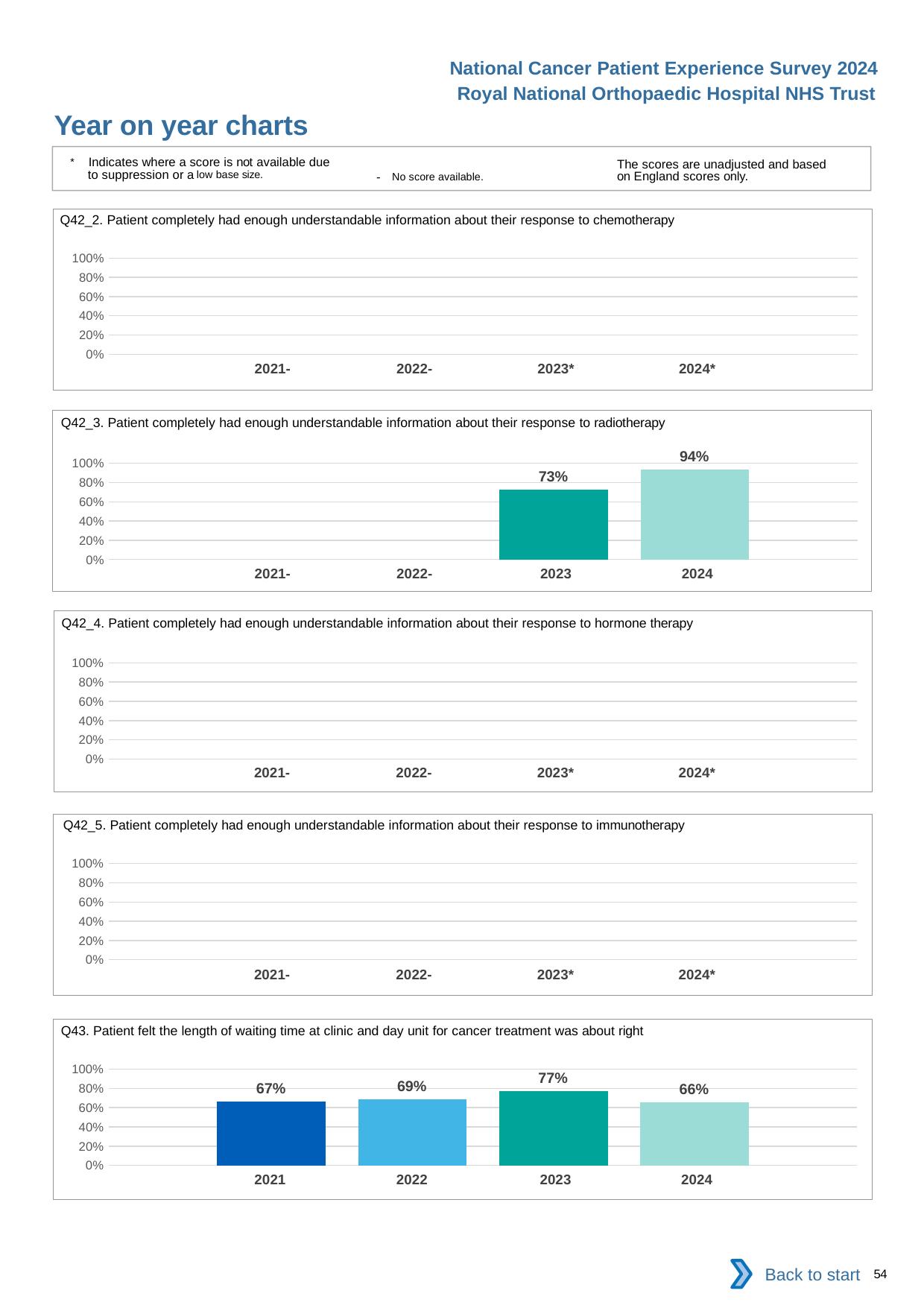
What kind of chart is the Q43 chart (waiting time at clinic and day unit)? bar chart In the Q42_3 chart (radiotherapy), what is the difference between the 2024 and 2023 values? 21% In the Q43 chart (waiting time at clinic and day unit), what is the difference between the 2023 and 2024 values? 11% In the Q42_3 chart (radiotherapy), how many years have a bar plotted? 2 In the Q43 chart (waiting time at clinic and day unit), which year has the highest value? 2023 In the Q42_3 chart (radiotherapy), is the value for 2023 greater or less than 80%? less In the Q43 chart (waiting time at clinic and day unit), which year has the lowest value? 2024 In the Q43 chart (waiting time at clinic and day unit), what is the value for 2022? 69% In the Q42_3 chart (radiotherapy), what is the value for 2024? 94% In the Q43 chart (waiting time at clinic and day unit), how many years have a bar plotted? 4 In the Q42_3 chart (radiotherapy), what is the value for 2023? 73% In the Q43 chart (waiting time at clinic and day unit), is the value for 2021 or 2022 larger? 2022